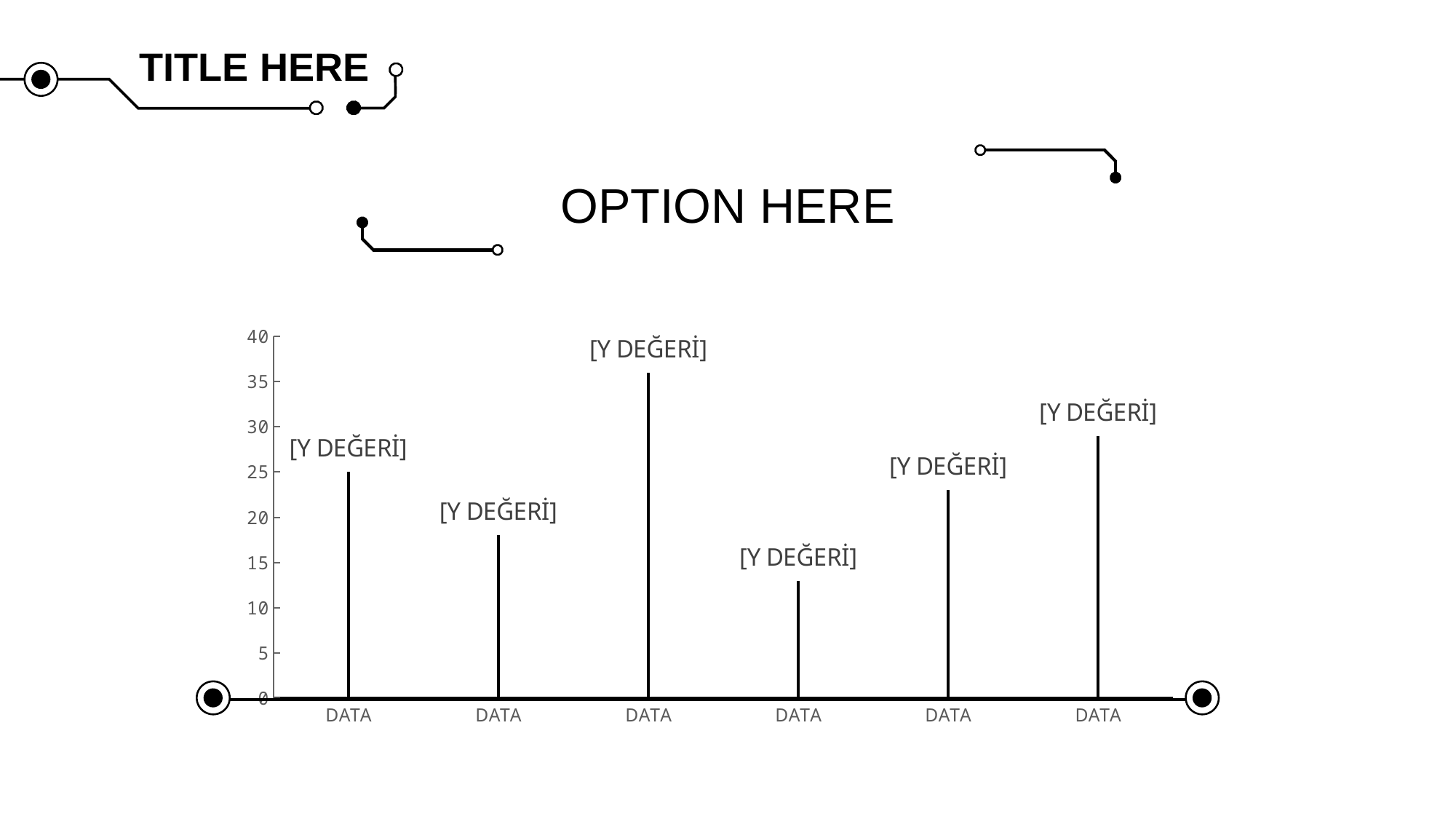
Is the value of the second bar greater or less than 20? less Which bar has the highest value in the chart? the third bar What kind of chart is shown on the slide? bar chart Is the value of the fourth bar greater or less than 15? less Is the value of the sixth bar greater or less than 25? greater Which is larger, the first bar or the second bar? the first bar How many bars are plotted in the chart? 6 Which bar has the lowest value in the chart? the fourth bar Which is larger, the fifth bar or the sixth bar? the sixth bar What is the highest value shown on the vertical axis of the chart? 40